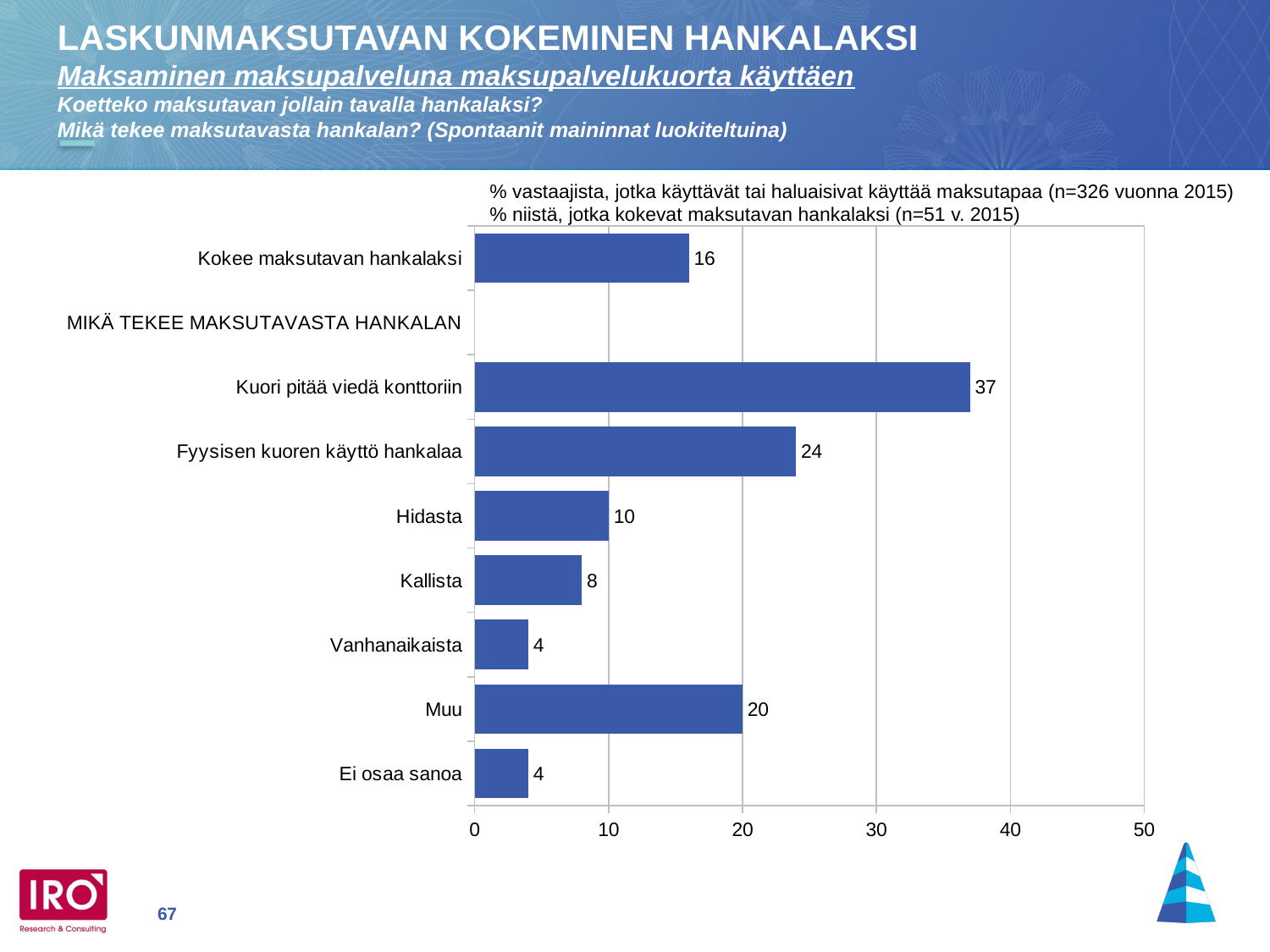
What value is shown for "Kuori pitää viedä konttoriin"? 37 Which has a larger value, "Hidasta" or "Kallista"? Hidasta Which has a larger value, "Muu" or "Kokee maksutavan hankalaksi"? Muu What kind of chart is shown on the slide? Bar chart What is the difference between the values for "Muu" and "Hidasta"? 10 How many bars are plotted in the chart? 8 What value is shown for "Muu"? 20 What value is shown for "Kokee maksutavan hankalaksi"? 16 What is the difference between the values for "Kuori pitää viedä konttoriin" and "Fyysisen kuoren käyttö hankalaa"? 13 What value is shown for "Kallista"? 8 Which category has the highest value in the chart? Kuori pitää viedä konttoriin What value is shown for "Fyysisen kuoren käyttö hankalaa"? 24